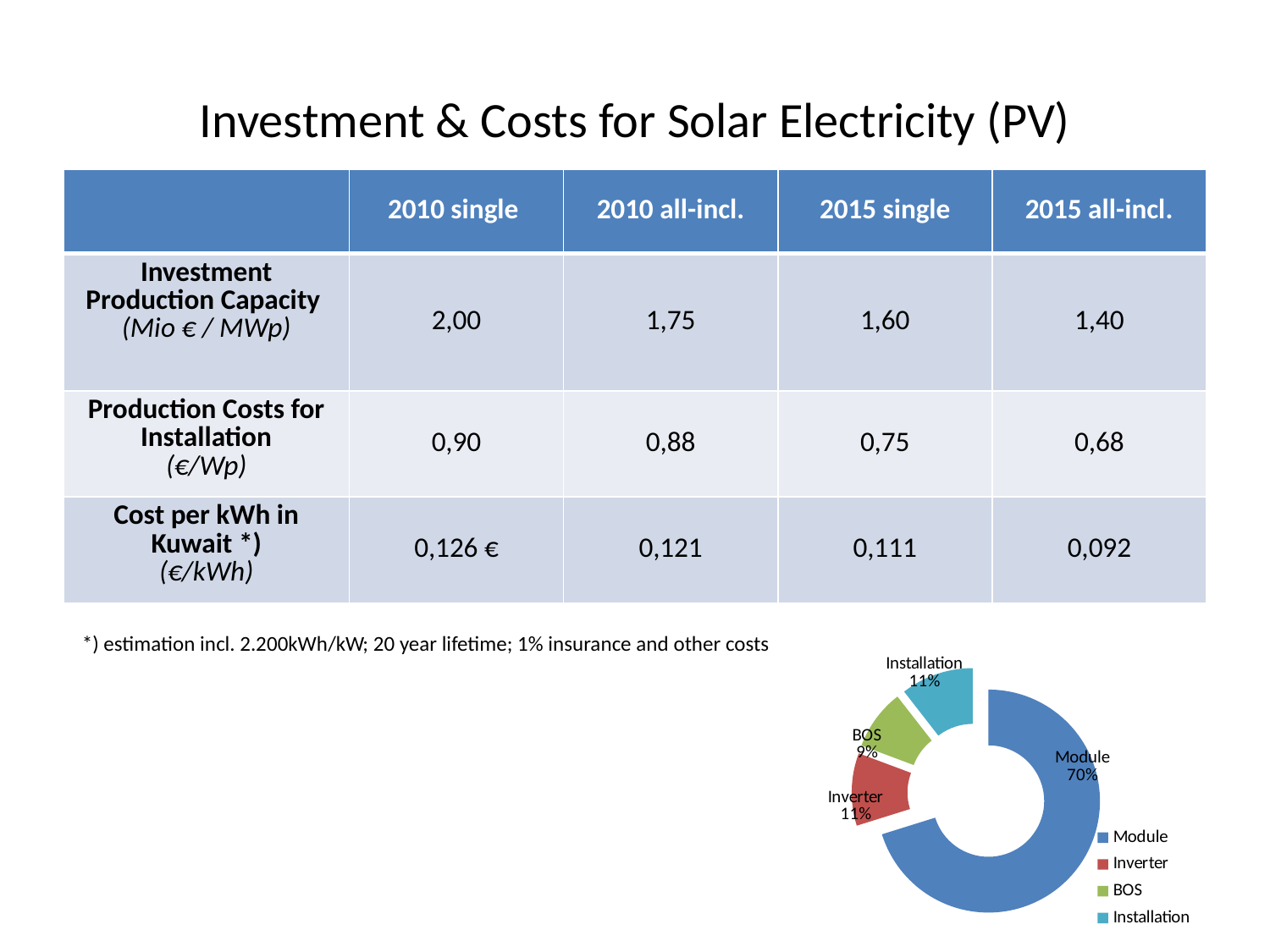
How many entries does the legend of the doughnut chart list? 4 In the doughnut chart, what percentage is shown for BOS? 9% In the doughnut chart, what share does Module account for? 70% In the doughnut chart, which is larger: Module or Inverter? Module In the doughnut chart, what is the difference in percentage points between Module and BOS? 61 What colour is the Module slice in the doughnut chart? blue In the doughnut chart, what percentage is shown for Inverter? 11% Which category has the largest slice in the doughnut chart? Module In the doughnut chart, what percentage is shown for Installation? 11% Which category has the smallest slice in the doughnut chart? BOS How many categories are shown in the doughnut chart? 4 What type of chart is shown on the slide? doughnut chart